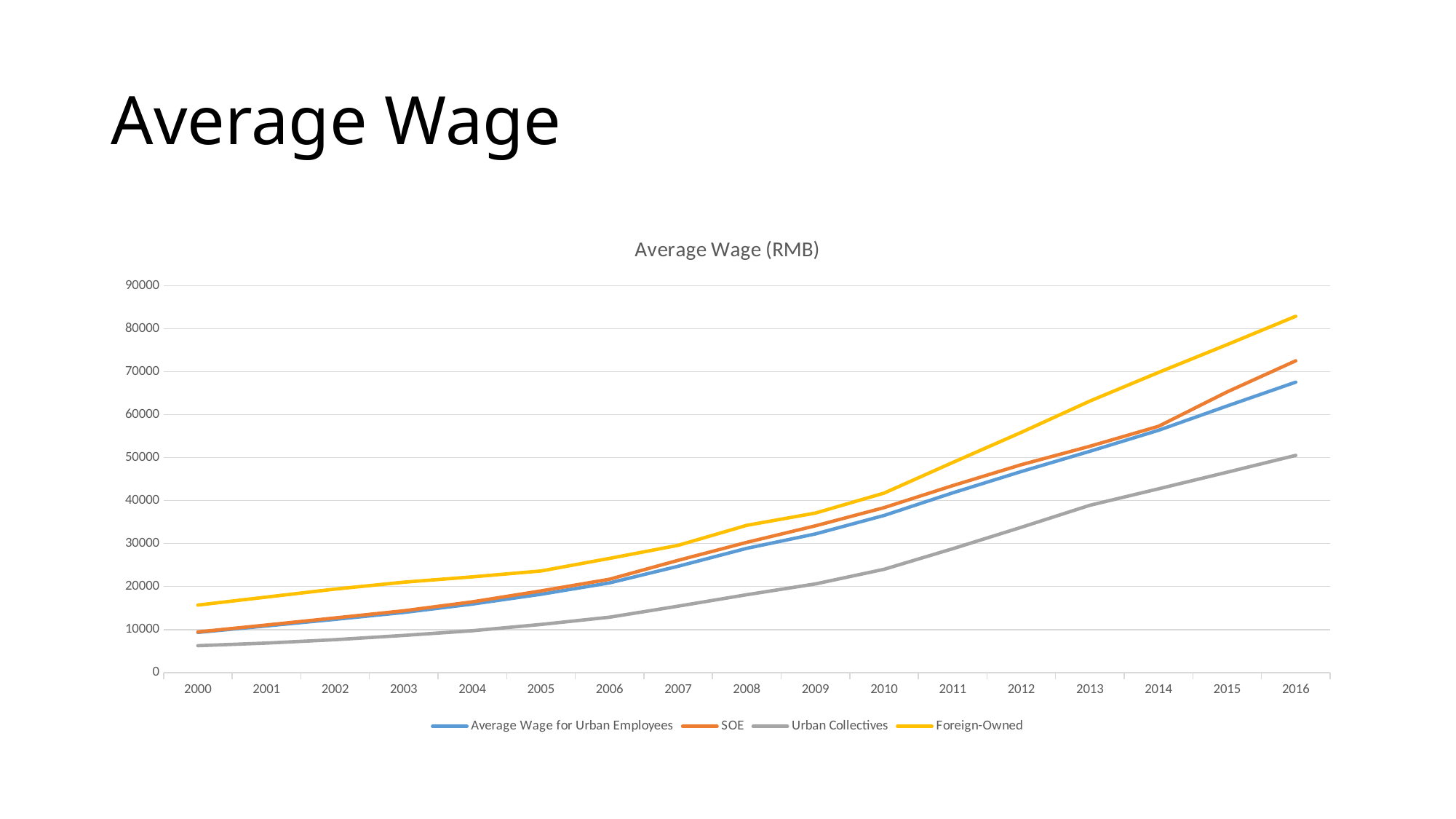
Is the value for Urban Collectives in 2000 greater or less than 10000? less What kind of chart is shown on the slide? line chart Which series has the lowest value in 2016? Urban Collectives Is the value for SOE in 2016 greater or less than 70000? greater How many years are plotted along the x axis? 17 Do the values for Foreign-Owned rise or fall from 2000 to 2016? rise Is the value for Average Wage for Urban Employees in 2016 greater or less than 70000? less How many series does the legend list? 4 Which series has the highest value in 2016? Foreign-Owned In 2014, which is larger: SOE or Urban Collectives? SOE What is the title of the chart? Average Wage (RMB)